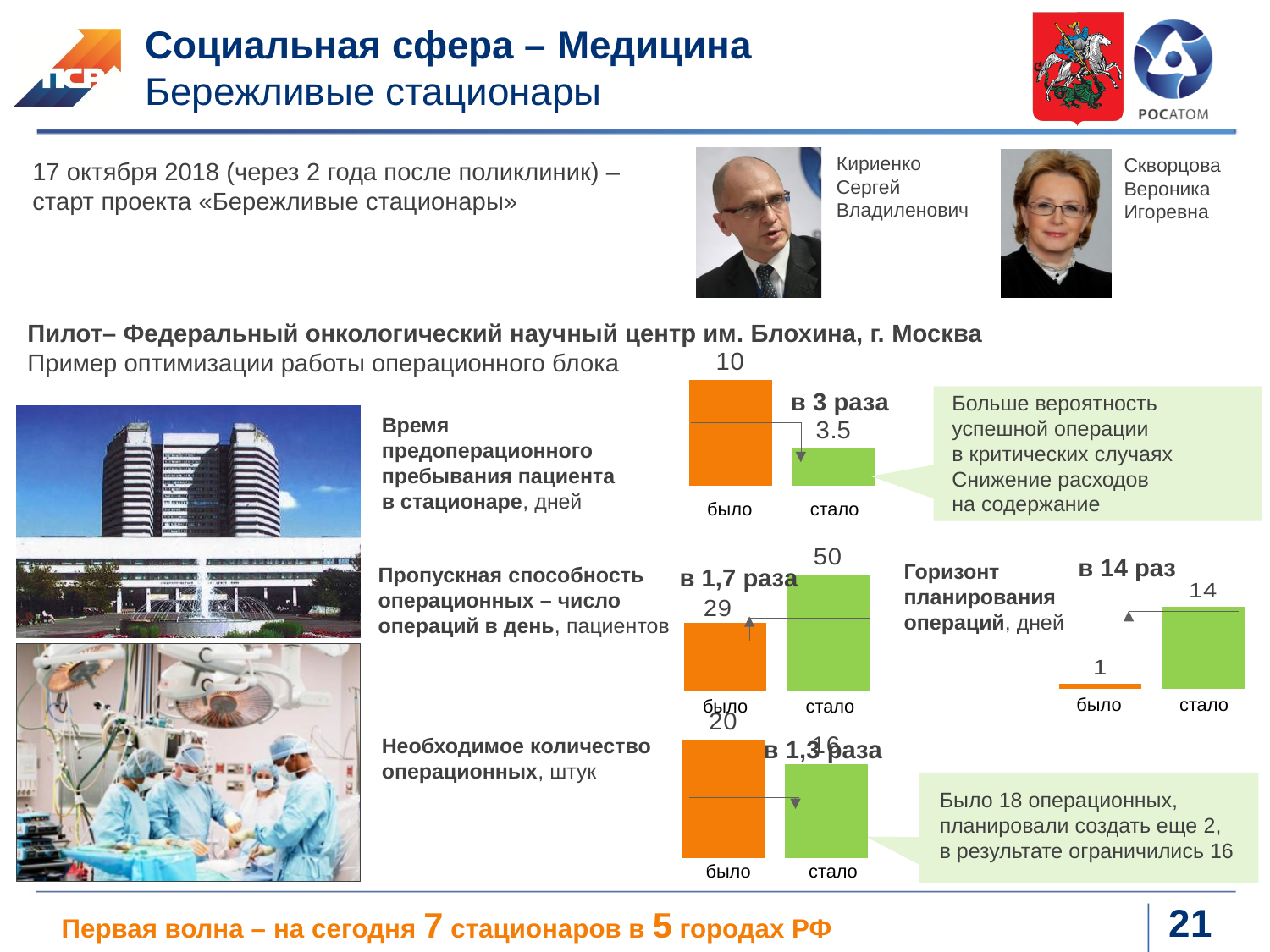
What type of chart is used for 'Горизонт планирования операций, дней'? bar chart In the chart 'Время предоперационного пребывания пациента в стационаре, дней', what is the difference between 'было' and 'стало'? 6.5 In the chart 'Необходимое количество операционных, штук', what is the value for 'было'? 20 In the chart 'Пропускная способность операционных – число операций в день, пациентов', by how much does 'стало' exceed 'было'? 21 In the chart 'Пропускная способность операционных – число операций в день, пациентов', what is the value for 'было'? 29 In the chart 'Горизонт планирования операций, дней', what is the value for 'было'? 1 In the chart 'Пропускная способность операционных – число операций в день, пациентов', which bar is higher, 'было' or 'стало'? стало In the chart 'Пропускная способность операционных – число операций в день, пациентов', what is the value for 'стало'? 50 In the chart 'Время предоперационного пребывания пациента в стационаре, дней', what is the value for 'стало'? 3.5 In the chart 'Необходимое количество операционных, штук', which bar is lower, 'было' or 'стало'? стало In the chart 'Горизонт планирования операций, дней', what is the value for 'стало'? 14 In the chart 'Время предоперационного пребывания пациента в стационаре, дней', what is the value for 'было'? 10